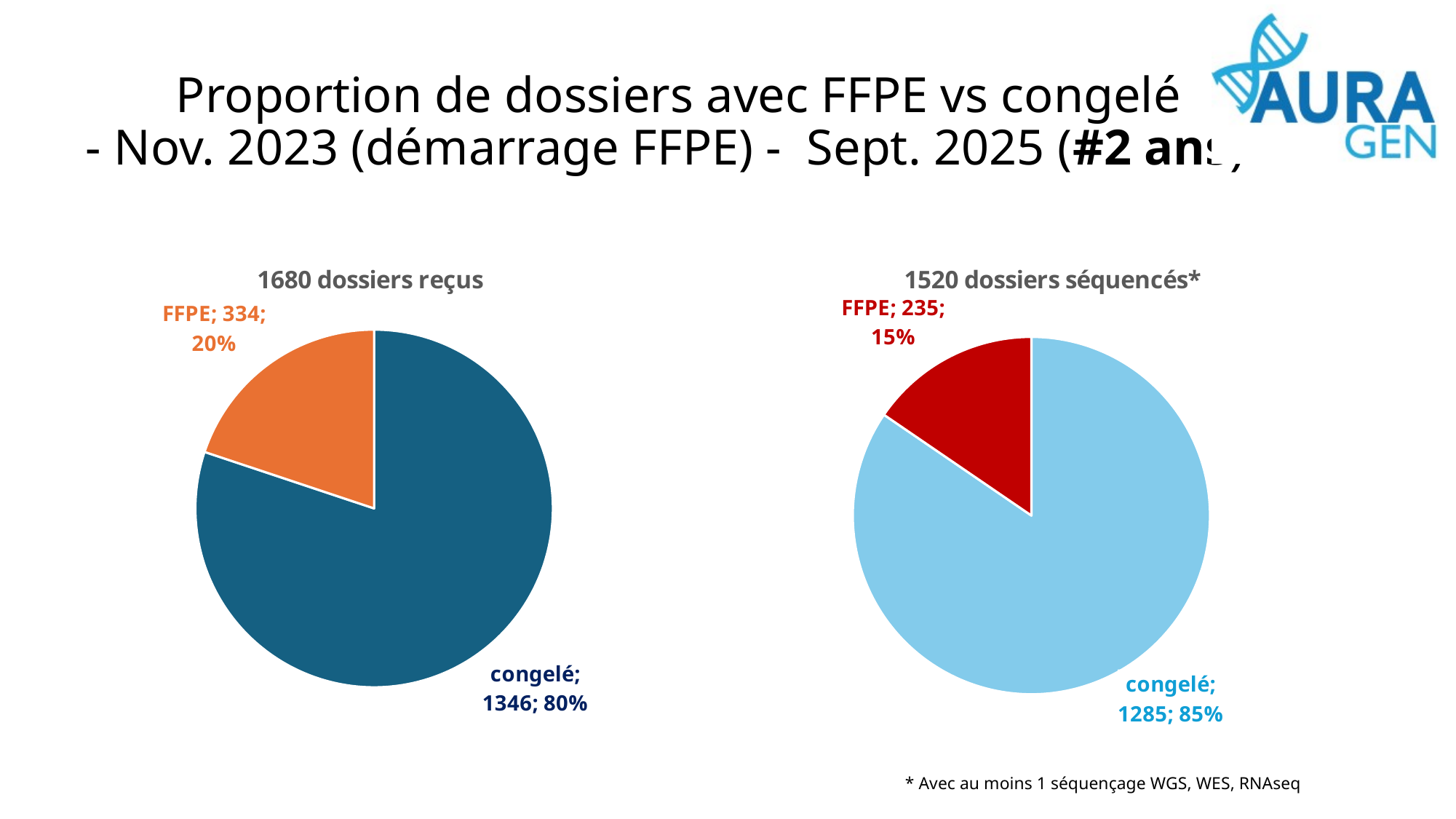
In the '1520 dossiers séquencés*' chart, how many dossiers are congelé? 1285 Which is larger: the FFPE count in the '1680 dossiers reçus' chart or the FFPE count in the '1520 dossiers séquencés*' chart? 1680 dossiers reçus (334) In the '1680 dossiers reçus' chart, what is the difference between the congelé and FFPE counts? 1012 In the '1520 dossiers séquencés*' chart, what share of the pie is congelé? 85% In the '1680 dossiers reçus' chart, which category is the largest? congelé In the '1520 dossiers séquencés*' chart, how many dossiers are FFPE? 235 In the '1680 dossiers reçus' chart, how many dossiers are FFPE? 334 In the '1680 dossiers reçus' chart, how many dossiers are congelé? 1346 In the '1680 dossiers reçus' chart, what share of the pie is FFPE? 20% What type of chart is the '1520 dossiers séquencés*' chart? Pie chart How many categories does the '1680 dossiers reçus' chart show? 2 In the '1520 dossiers séquencés*' chart, which category is the smallest? FFPE